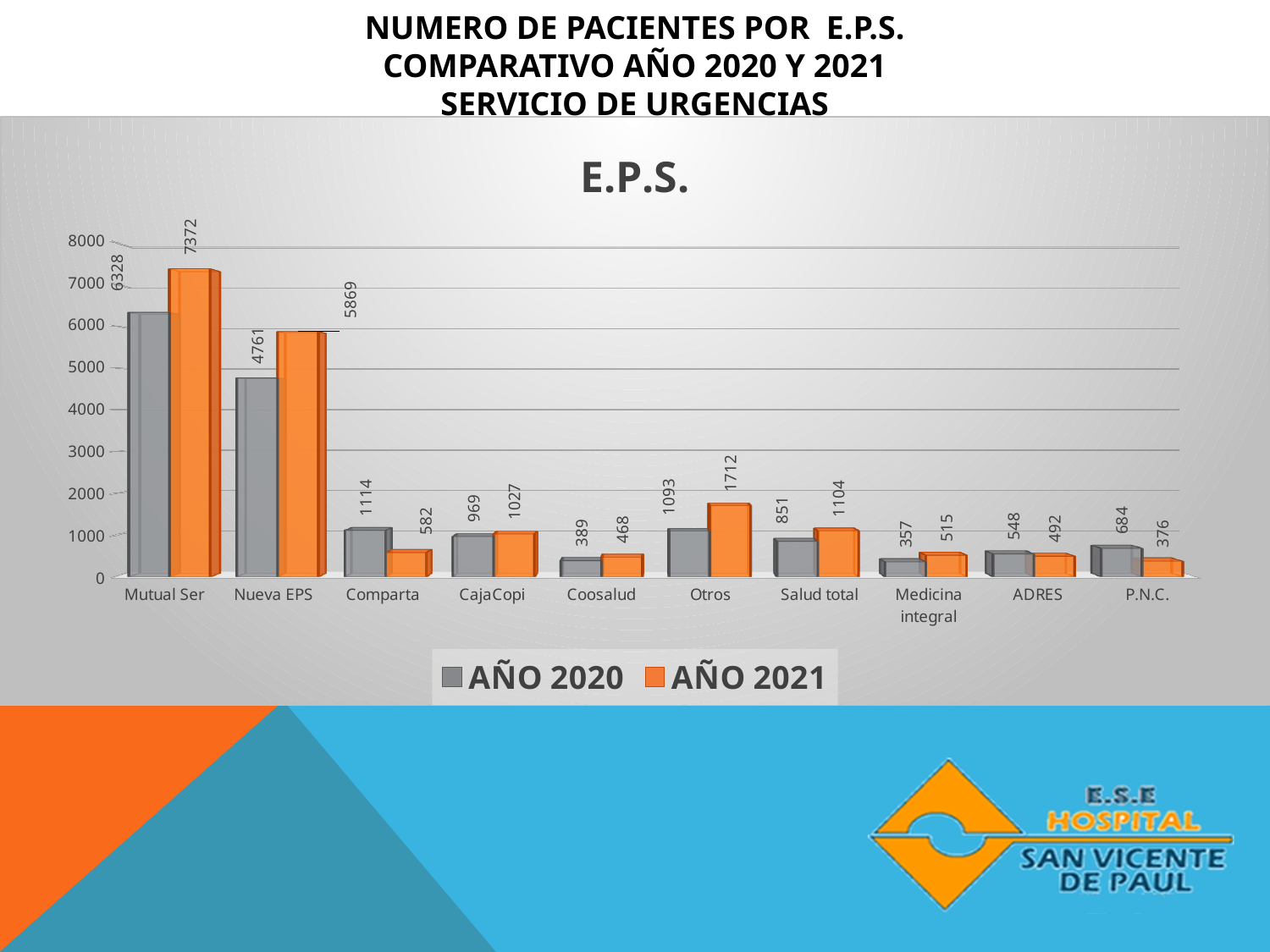
What is the value for Medicina integral in the AÑO 2021 series? 515 What is the value for Comparta in the AÑO 2020 series? 1114 Which is larger for P.N.C., the AÑO 2020 value or the AÑO 2021 value? AÑO 2020 What kind of chart is shown on the slide? Bar chart How many categories are shown on the x axis? 10 Which category has the lowest value in the AÑO 2021 series? P.N.C. What is the difference between the AÑO 2021 and AÑO 2020 values for Nueva EPS? 1108 Is the AÑO 2021 value for Otros greater or less than 1000? greater How many series does the legend list? 2 Which category has the highest value in the AÑO 2020 series? Mutual Ser What is the value for Mutual Ser in the AÑO 2021 series? 7372 What is the title shown above the chart's plot area? E.P.S.